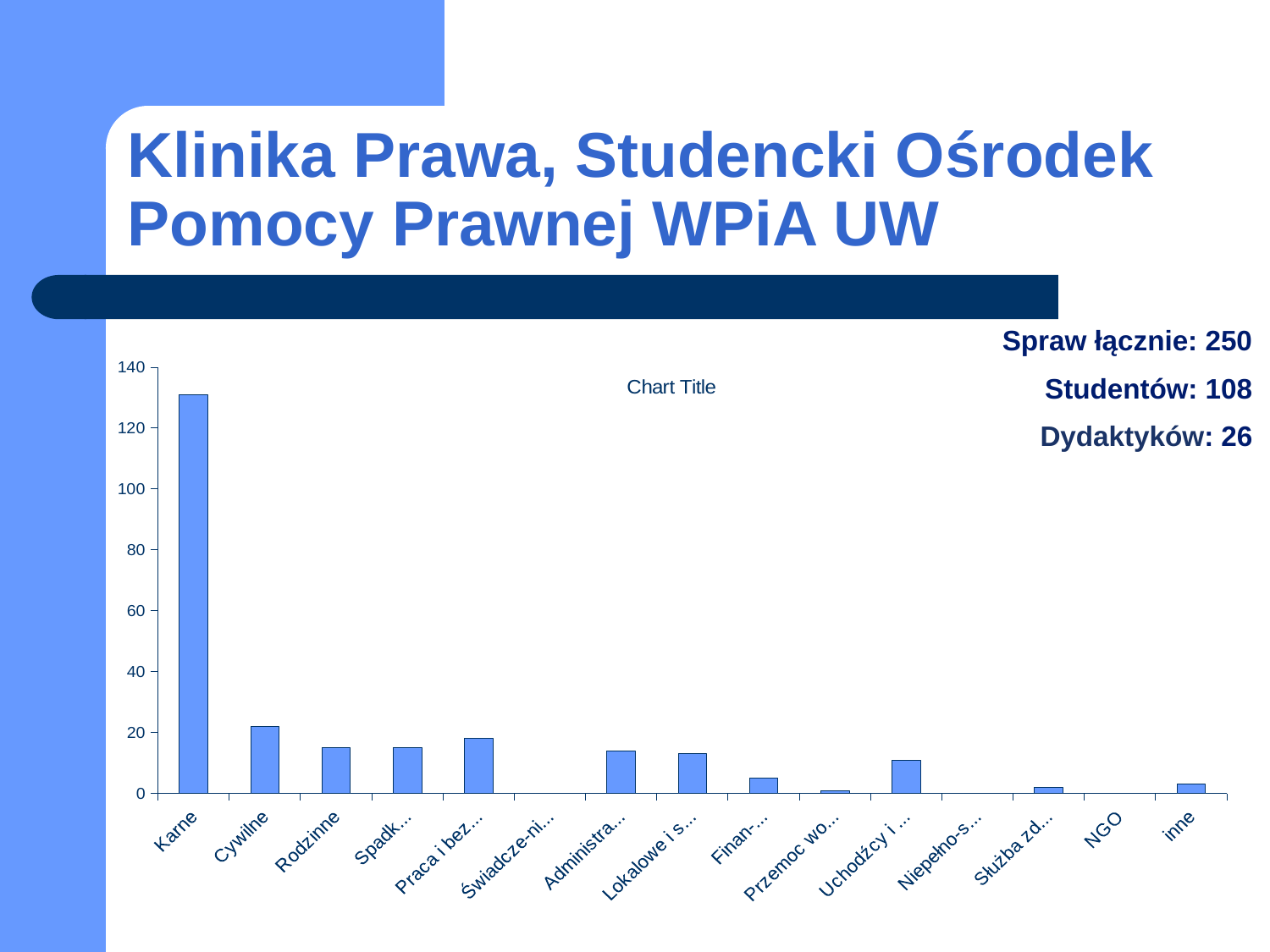
What kind of chart is shown on the slide? bar chart Which is larger, the value for Rodzinne or the value for inne? Rodzinne What is the highest value shown on the chart's vertical axis? 140 What is the title shown on the chart? Chart Title Is the value for Karne greater or less than 140? less How many categories are shown on the x axis of the chart? 15 Which is larger, the value for Karne or the value for Cywilne? Karne Which is larger, the value for Cywilne or the value for Rodzinne? Cywilne Is the value for Rodzinne greater or less than 20? less Which category has the highest value in the chart? Karne Is the value for Karne greater or less than 120? greater